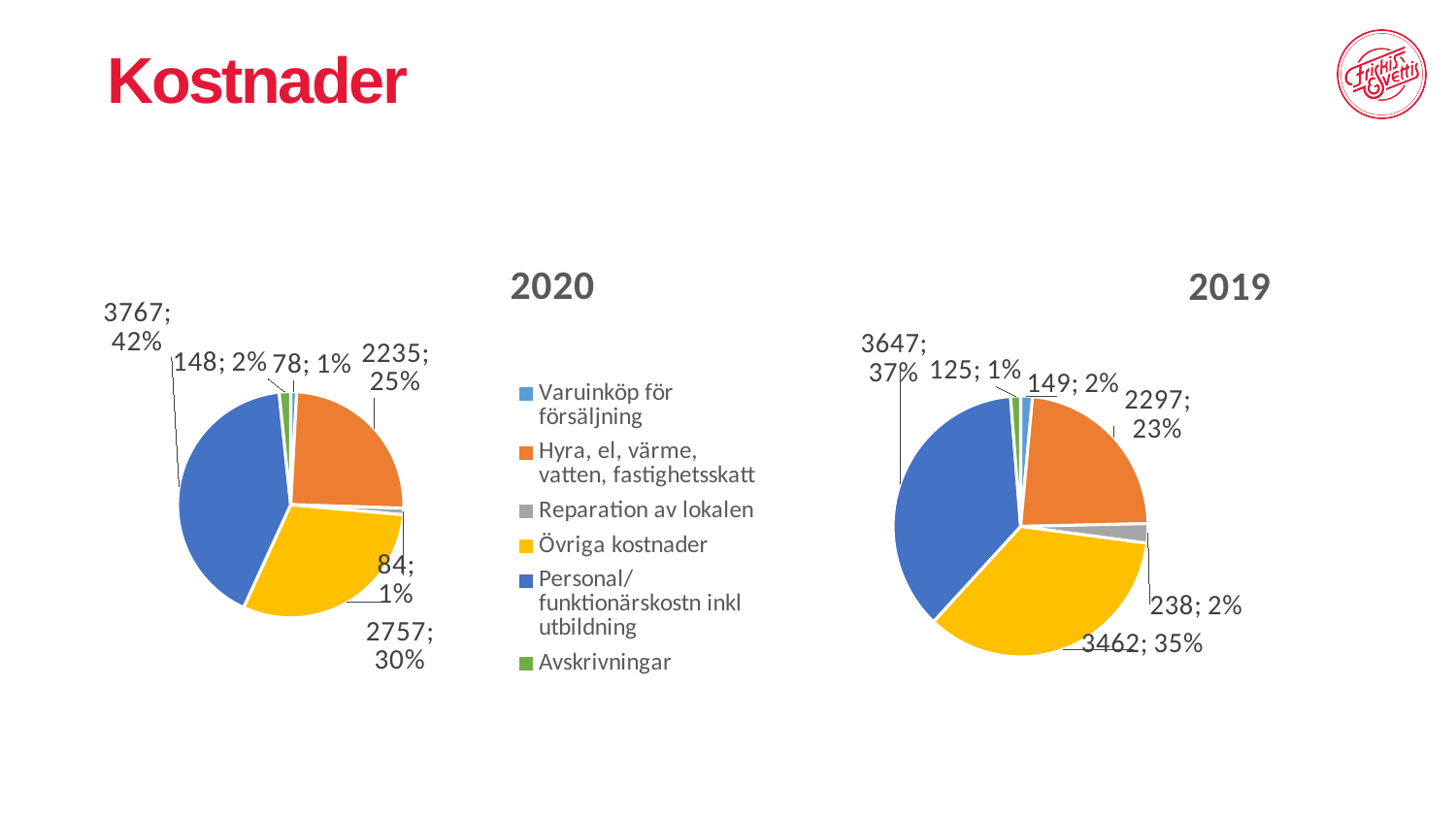
In the 2019 pie chart, what share of costs is Personal/funktionärskostn inkl utbildning? 37% In the 2019 pie chart, what is the value for Hyra, el, värme, vatten, fastighetsskatt? 2297 What kind of chart is used for the 2020 and 2019 costs on this slide? Pie chart In the 2020 pie chart, what share of costs is Övriga kostnader? 30% In the 2020 pie chart, which category is the largest? Personal/funktionärskostn inkl utbildning In the 2020 pie chart, what is the value for Personal/funktionärskostn inkl utbildning? 3767 How many cost categories does the legend list? 6 In the 2020 pie chart, what is the difference between Personal/funktionärskostn inkl utbildning and Övriga kostnader? 1010 In the 2019 pie chart, which category is the smallest? Avskrivningar What is the title of the slide containing the two pie charts? Kostnader In the 2019 pie chart, which is larger: Övriga kostnader or Hyra, el, värme, vatten, fastighetsskatt? Övriga kostnader In the 2020 pie chart, what is the value for Reparation av lokalen? 84